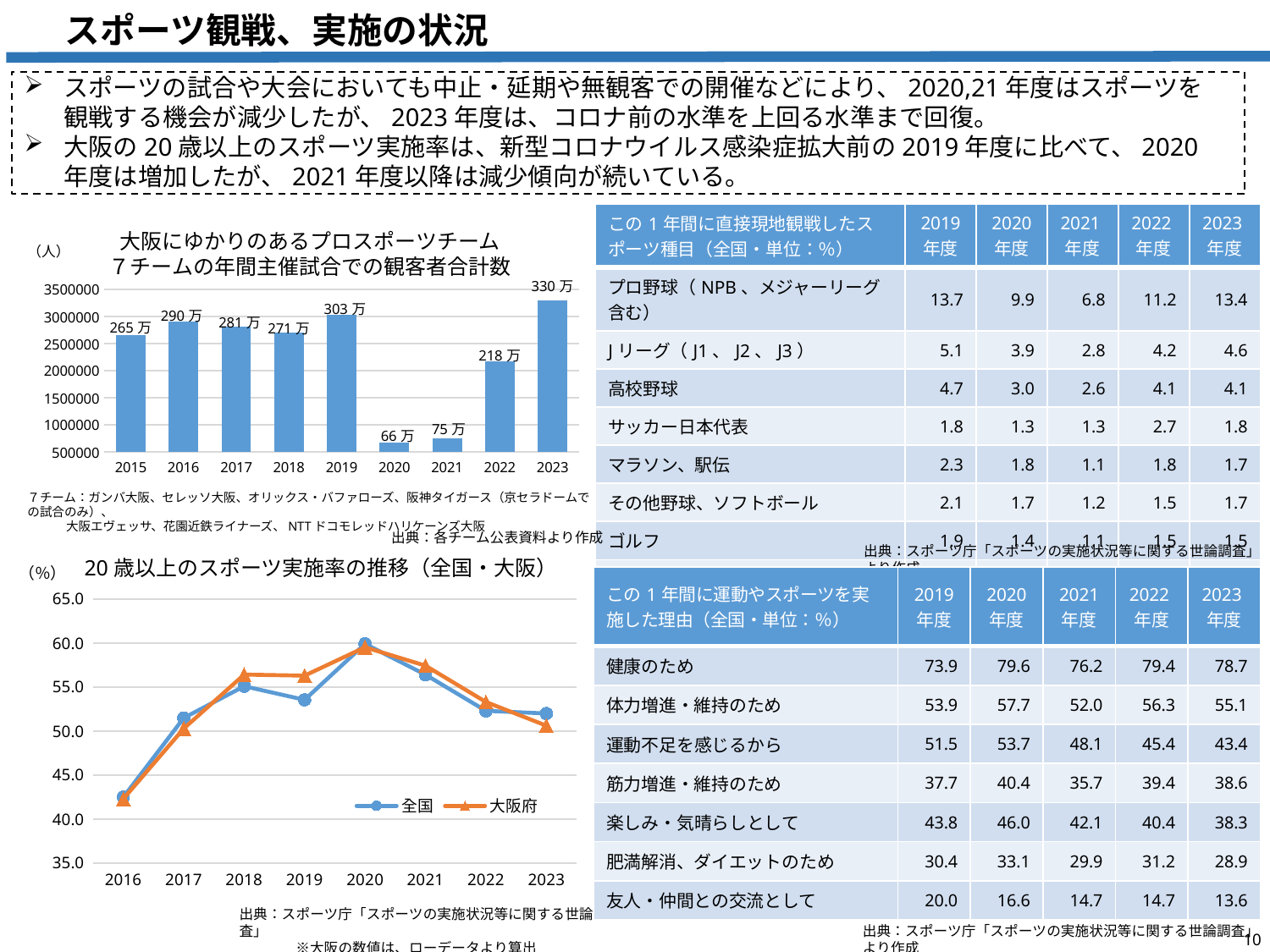
How many series does the legend of the line chart of sports participation rate (20歳以上) list? 2 In the bar chart of annual spectator totals, what is the difference between the 2023 value and the 2020 value? 264万 What kind of chart is the chart of annual spectator totals for the 7 Osaka-related pro sports teams? bar chart In the line chart of sports participation rate, is the value for 大阪府 in 2020 greater or less than 55.0? greater In the line chart of sports participation rate, is the value for 全国 in 2016 greater or less than 45.0? less In the bar chart of annual spectator totals, which year has the highest value? 2023 In the line chart of sports participation rate, do the values for 全国 rise or fall from 2020 to 2023? fall In the bar chart of annual spectator totals, which year has the lowest value? 2020 In the bar chart of annual spectator totals for the 7 Osaka-related pro sports teams, what is the value for 2022? 218万 In the bar chart of annual spectator totals for the 7 Osaka-related pro sports teams, what is the value for 2019? 303万 In the bar chart of annual spectator totals, which year has the larger value, 2016 or 2017? 2016 How many years are shown on the x axis of the bar chart of annual spectator totals? 9